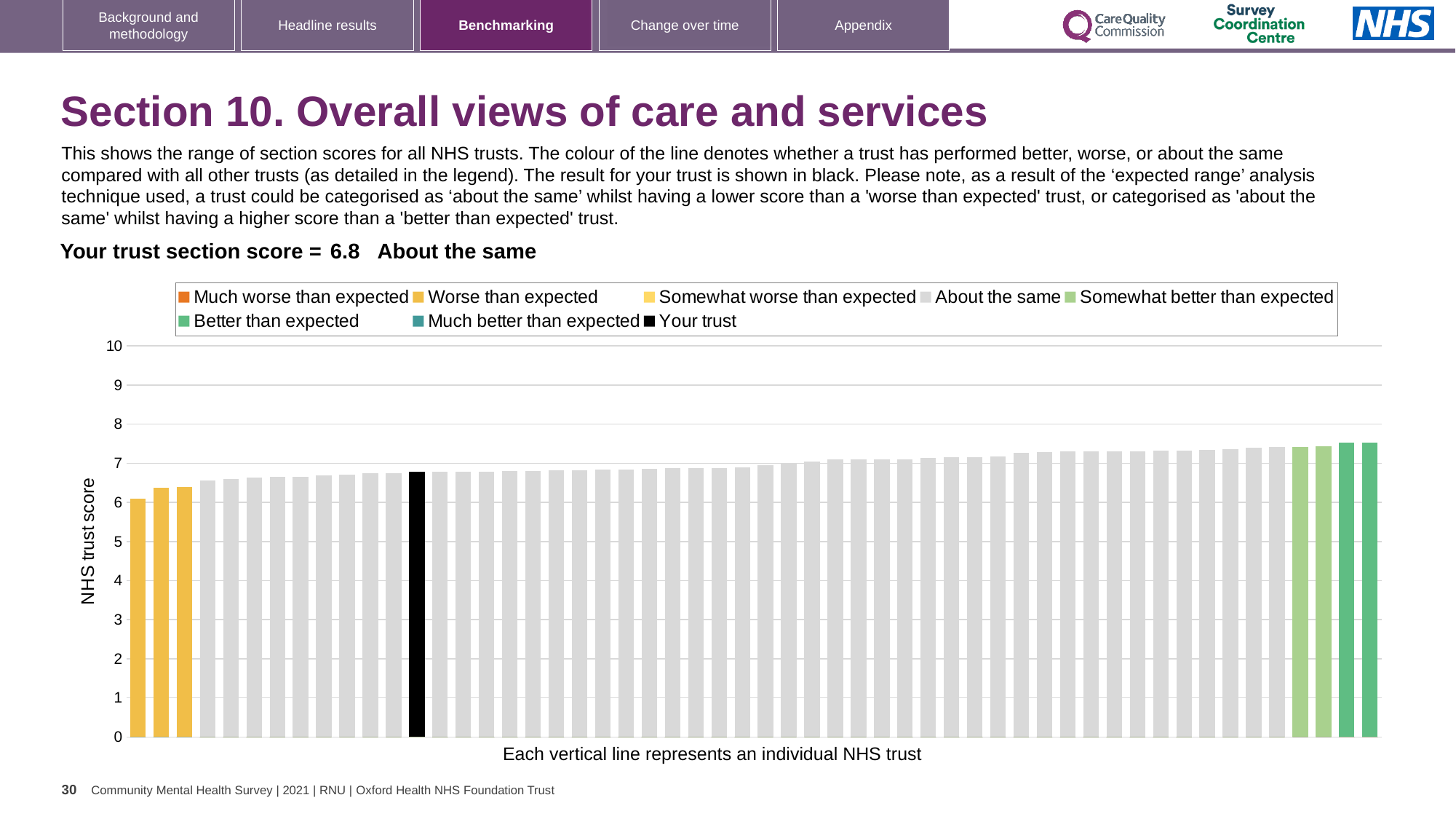
Which category is your trust placed in for this section? About the same Is the value of the tallest bar greater or less than 7? greater What colour does the legend use for 'Your trust'? black Which is larger: the value for your trust (black bar) or the value of the leftmost bar? Your trust Is the value of the leftmost bar greater or less than 7? less How many entries does the chart legend list? 8 Is the value of the tallest bar greater or less than 8? less What is the section score for your trust shown on the slide? 6.8 Do the bar values rise or fall from left to right along the x axis? rise What is the label on the vertical axis of the chart? NHS trust score What kind of chart is shown on the slide? bar chart